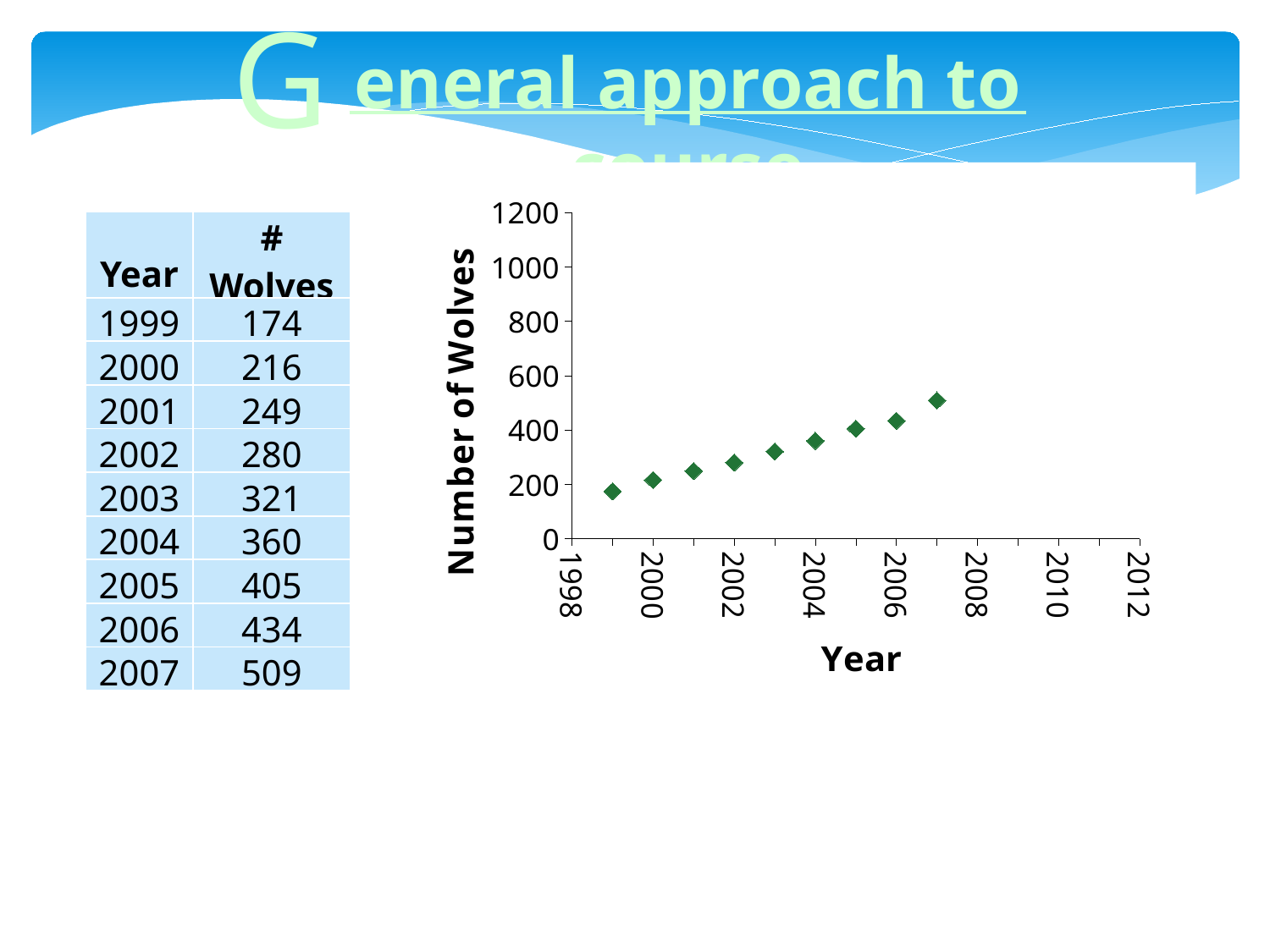
What is the difference in the number of wolves between 2007 and 1999? 335 What is the label on the vertical axis of the chart? Number of Wolves How many data points are plotted on the chart? 9 What is the number of wolves in 2007? 509 Which year has the highest number of wolves? 2007 What kind of chart is shown on the slide? scatter chart What is the number of wolves in 2004? 360 Do the values on the chart rise or fall as the year increases? rise What is the number of wolves in 1999? 174 Which year has the lowest number of wolves? 1999 Which year has more wolves, 2003 or 2005? 2005 Is the value for 2007 greater or less than 400? greater